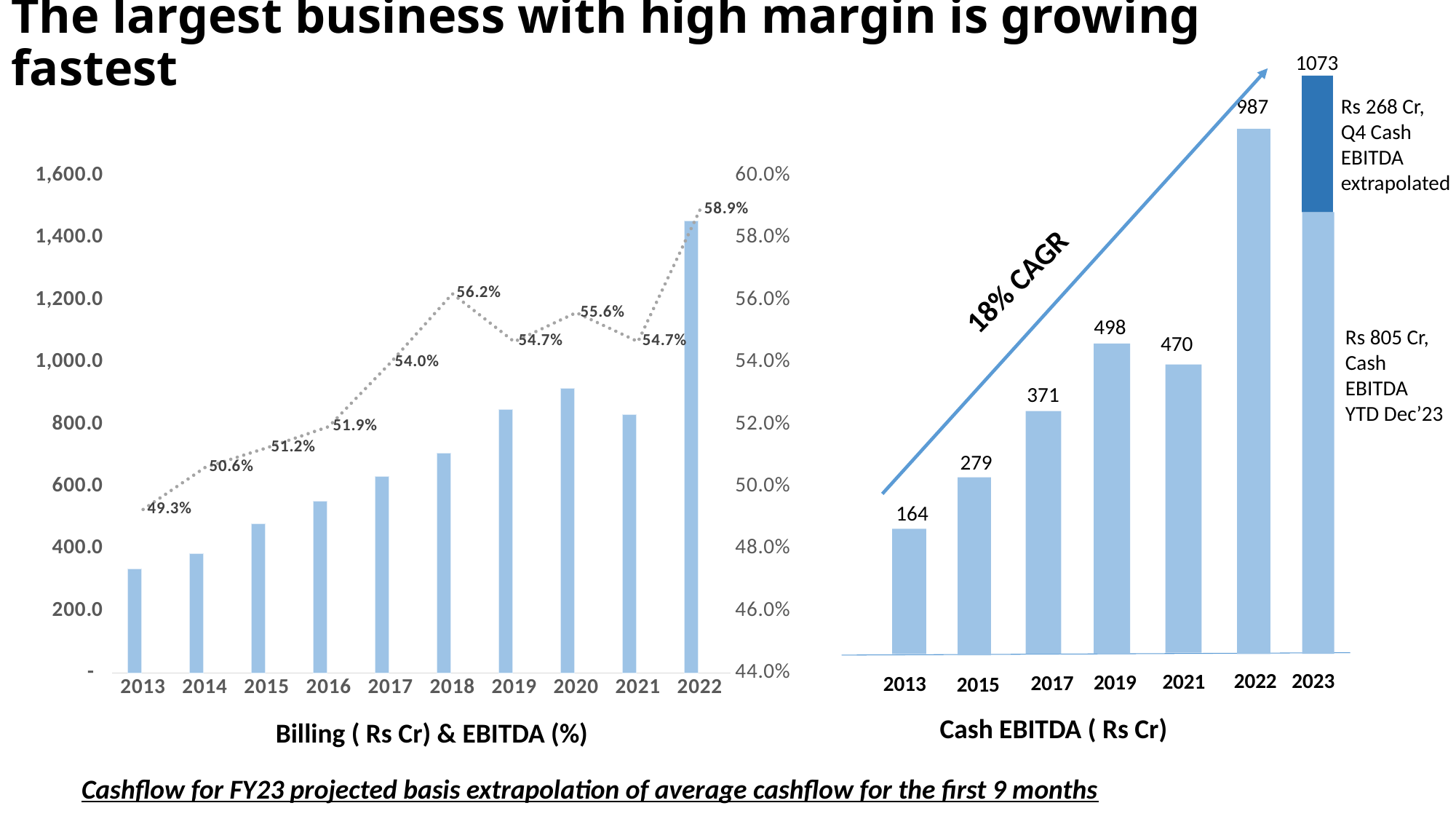
In the Billing ( Rs Cr) & EBITDA (%) chart, what is the EBITDA percentage for 2018? 56.2% In the Billing ( Rs Cr) & EBITDA (%) chart, which year has the lowest EBITDA percentage? 2013 In the Cash EBITDA ( Rs Cr) chart, what CAGR is written along the arrow? 18% CAGR In the Cash EBITDA ( Rs Cr) chart, how many years are shown on the x axis? 7 In the Cash EBITDA ( Rs Cr) chart, what is the total of the stacked 2023 bar? 1073 In the Cash EBITDA ( Rs Cr) chart, which year has the highest value? 2023 In the Cash EBITDA ( Rs Cr) chart, which year has the lowest value? 2013 In the Billing ( Rs Cr) & EBITDA (%) chart, which year has the highest EBITDA percentage? 2022 In the Billing ( Rs Cr) & EBITDA (%) chart, is the billing value for 2013 greater or less than 400.0? less In the Cash EBITDA ( Rs Cr) chart, what is the difference between the 2022 and 2021 values? 517 In the Cash EBITDA ( Rs Cr) chart, what is the value for 2019? 498 In the Billing ( Rs Cr) & EBITDA (%) chart, is the billing value for 2020 greater or less than 800.0? greater